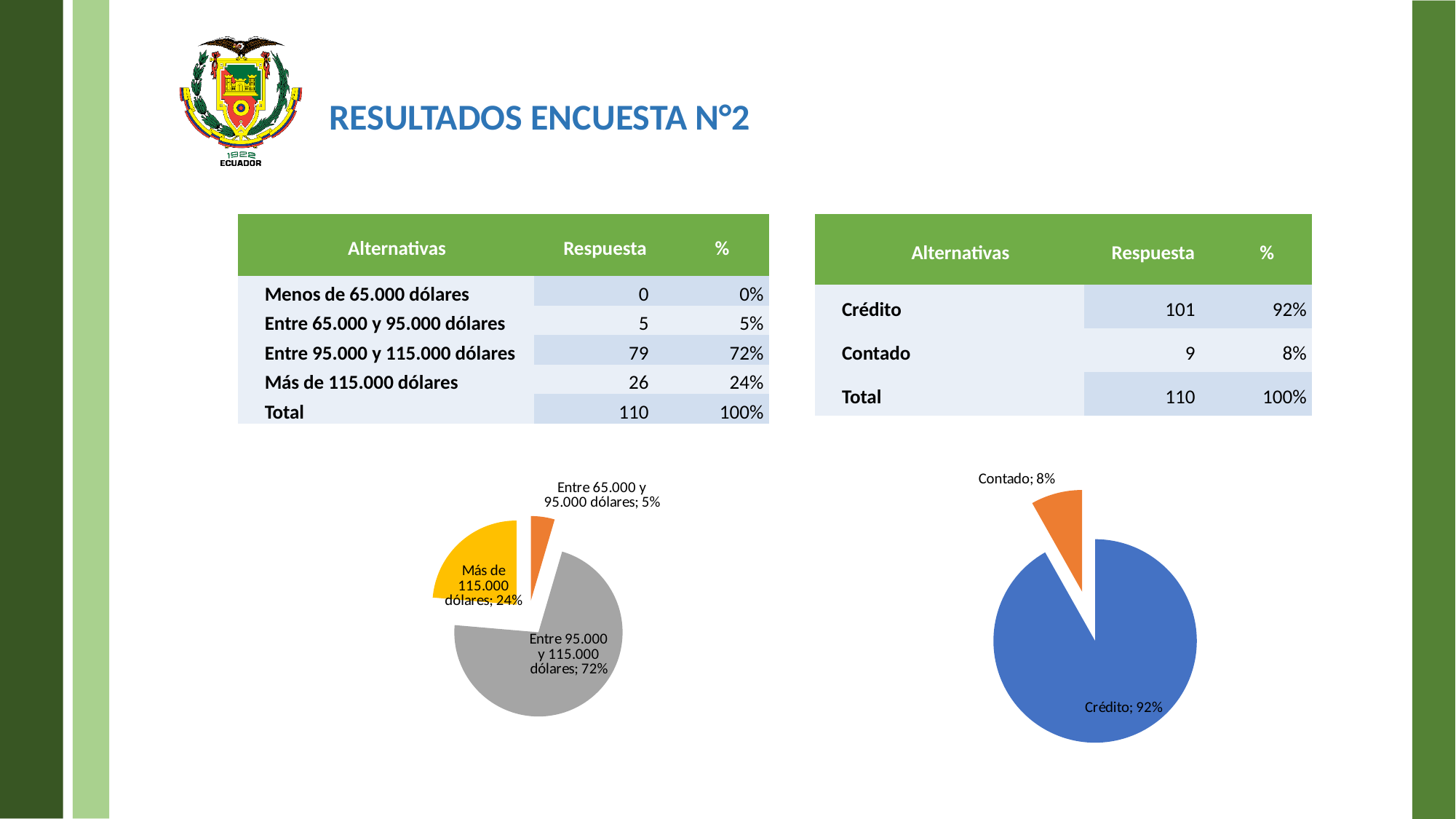
In the pie chart on the left, what share does the slice 'Más de 115.000 dólares' have? 24% In the pie chart on the right, which is larger, 'Crédito' or 'Contado'? Crédito In the pie chart on the left, which slice is the largest? Entre 95.000 y 115.000 dólares In the pie chart on the left, which slice is the smallest? Entre 65.000 y 95.000 dólares In the pie chart on the left, what share does the slice 'Entre 65.000 y 95.000 dólares' have? 5% In the pie chart on the left, what share does the slice 'Entre 95.000 y 115.000 dólares' have? 72% What kind of chart is the chart on the right of the slide? Pie chart In the pie chart on the right, what colour is the 'Contado' slice? Orange In the pie chart on the left, what is the difference in percentage points between 'Entre 95.000 y 115.000 dólares' and 'Más de 115.000 dólares'? 48 How many labelled slices does the pie chart on the left show? 3